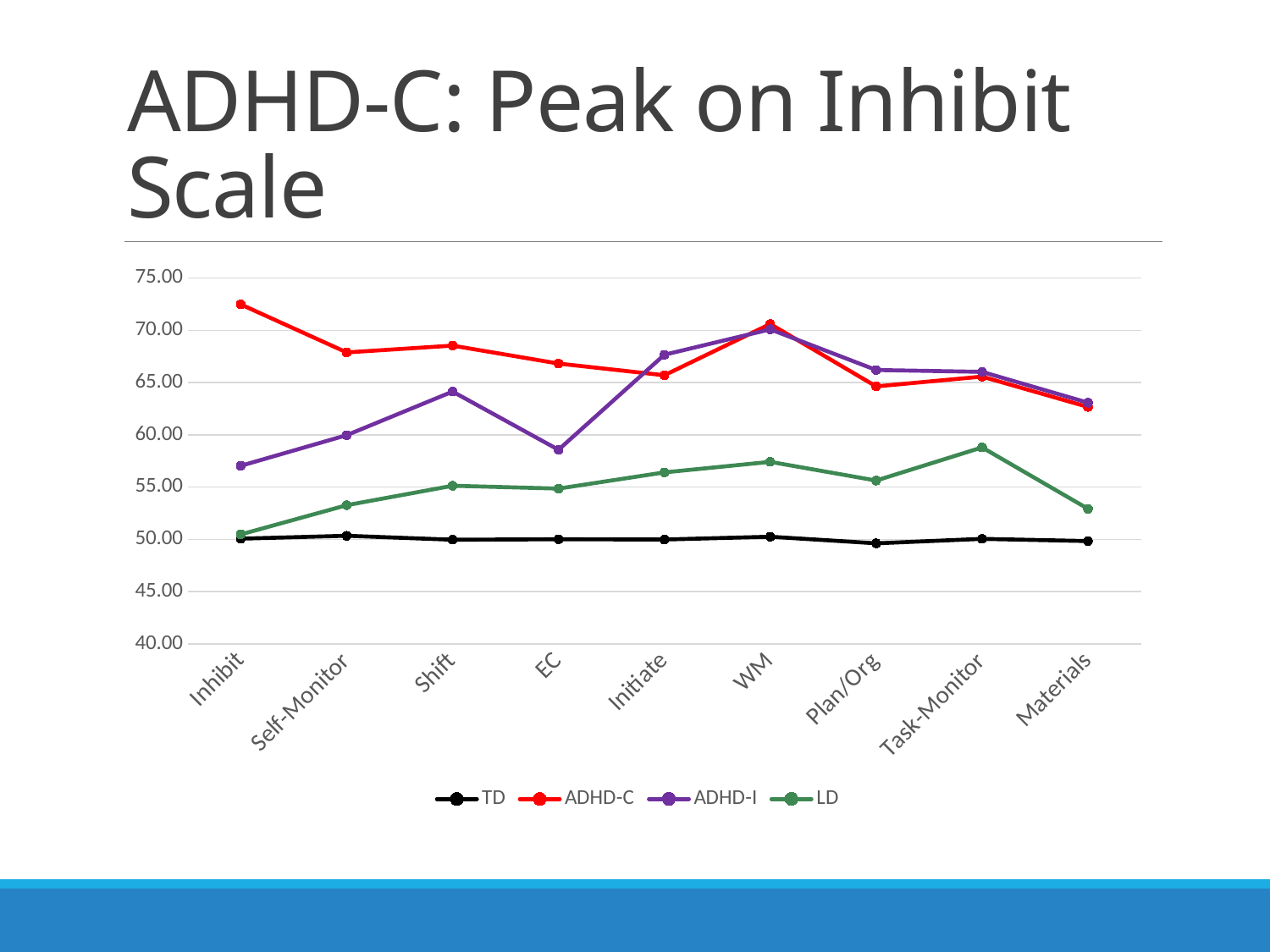
How many series does the legend list? 4 Is the ADHD-I value for Inhibit greater or less than 60.00? less Is the LD value for WM greater or less than 55.00? greater At EC, which series has the larger value, ADHD-I or LD? ADHD-I How many categories are shown on the x axis? 9 At Shift, which series has the larger value, ADHD-C or ADHD-I? ADHD-C What colour is the ADHD-C series line? Red What kind of chart is shown on the slide? Line chart For which category is the LD series lowest? Inhibit For which category is the ADHD-C series highest? Inhibit Is the ADHD-C value for Inhibit greater or less than 70.00? greater Does the ADHD-C series rise or fall from Inhibit to EC? fall